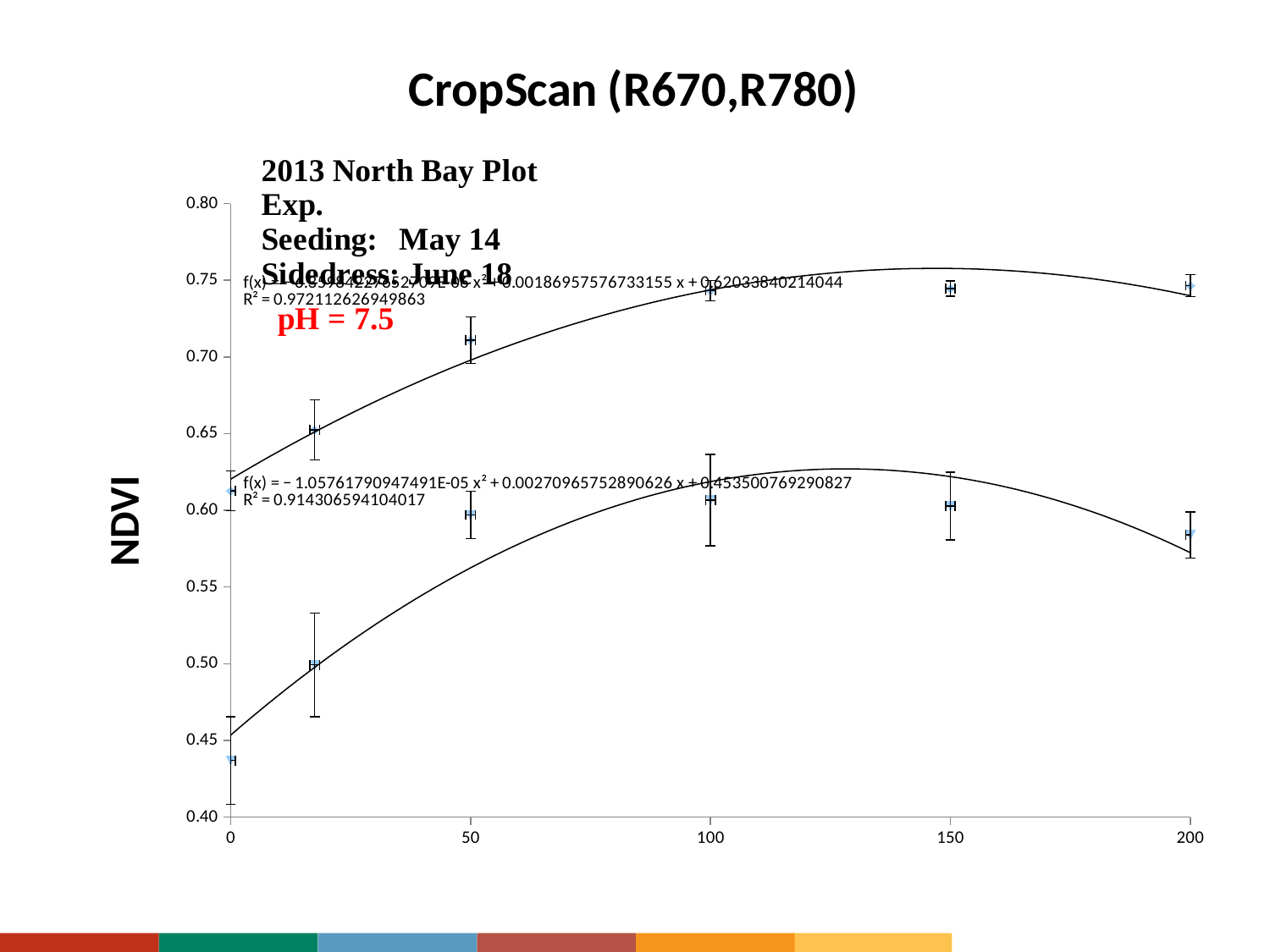
At which x value does the lower series reach its lowest NDVI? 0 At x = 0, which series has the larger NDVI value, the upper or the lower series? upper series Is the value of the lower series at x = 200 greater or less than 0.60? less What is the title of the chart? CropScan (R670,R780) Is the value of the upper series at x = 100 greater or less than 0.75? less What type of chart is shown on the slide? scatter chart Is the value of the upper series at x = 50 greater or less than 0.70? greater How many data series are plotted on the chart? 2 How many data points are plotted in the lower series? 6 Does the lower series rise or fall between x = 0 and x = 100? rise What is the label on the vertical axis of the chart? NDVI